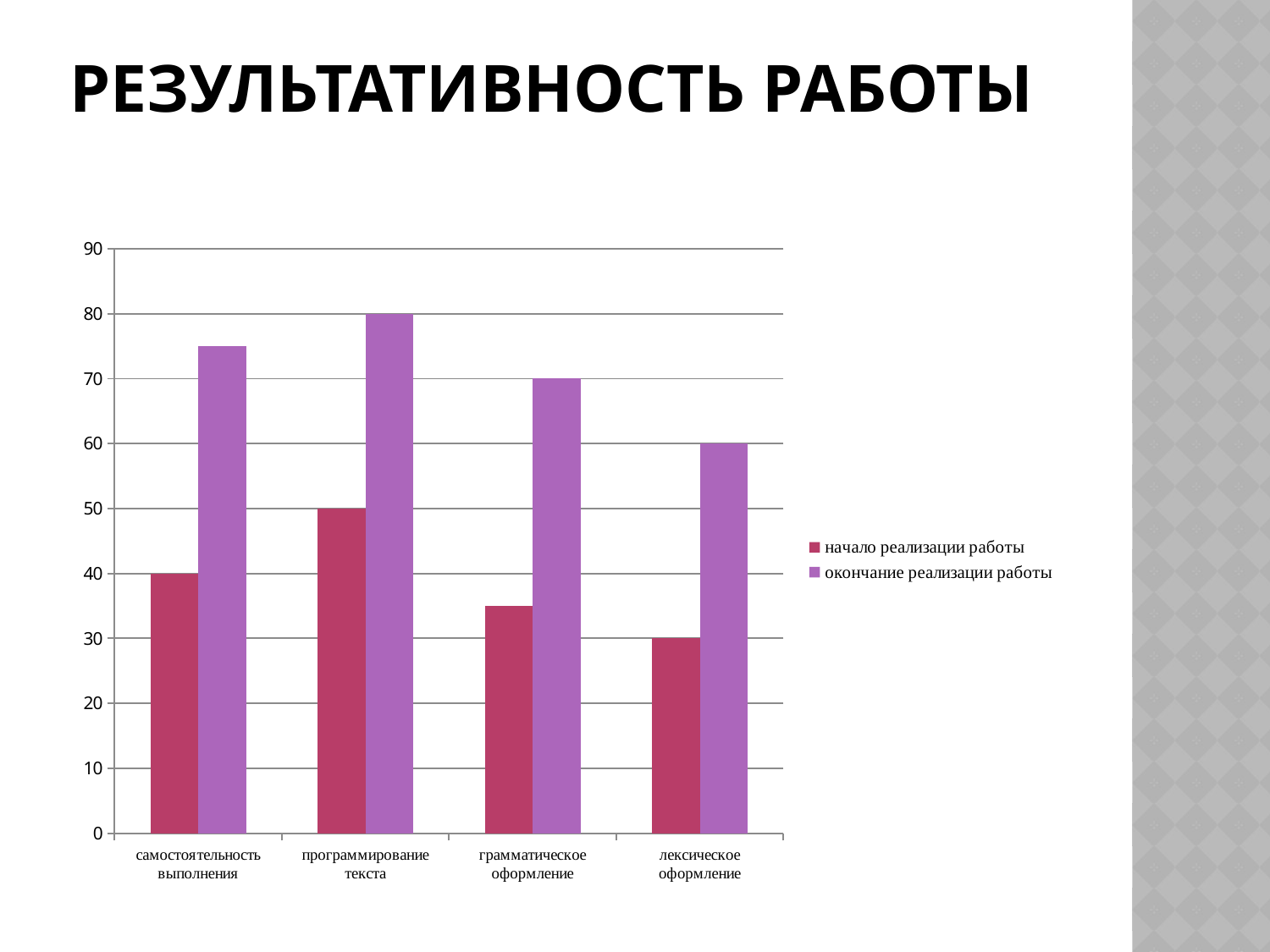
How many series does the legend list? 2 Which category has the highest value in the 'окончание реализации работы' series? программирование текста What is the value for 'программирование текста' in the 'окончание реализации работы' series? 80 What kind of chart is shown on the slide? bar chart What is the difference between the 'окончание реализации работы' and 'начало реализации работы' values for 'программирование текста'? 30 What is the value for 'грамматическое оформление' in the 'окончание реализации работы' series? 70 What is the value for 'лексическое оформление' in the 'начало реализации работы' series? 30 What is the title of the slide? РЕЗУЛЬТАТИВНОСТЬ РАБОТЫ Which category has the lowest value in the 'начало реализации работы' series? лексическое оформление How many categories are shown on the x axis? 4 Is the value for 'самостоятельность выполнения' in the 'окончание реализации работы' series greater or less than 70? greater What is the value for 'программирование текста' in the 'начало реализации работы' series? 50